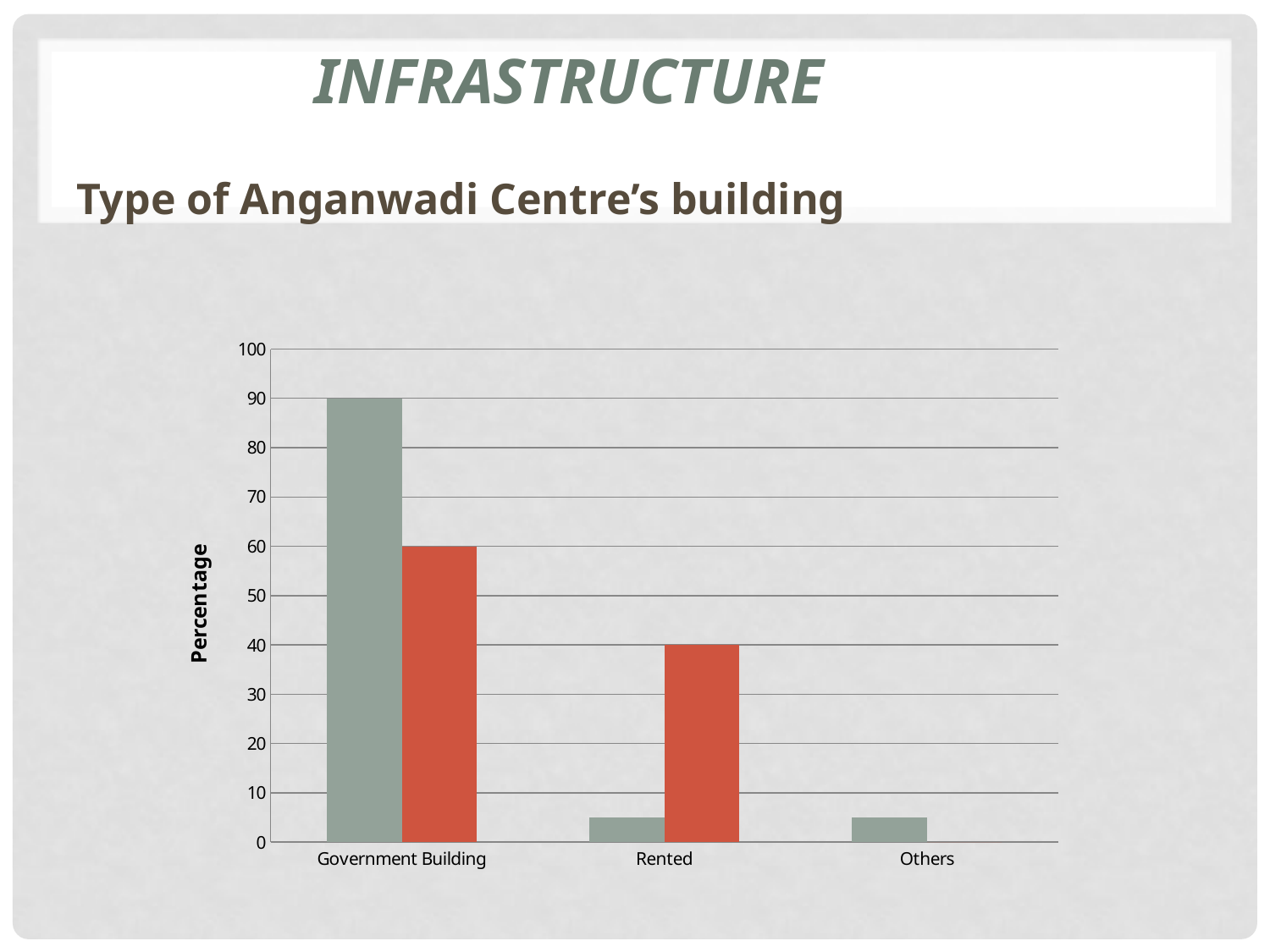
What is the label on the vertical axis of the chart? Percentage Is the value of the grey bar for Rented greater or less than 10? less What is the value of the red bar for Government Building? 60 For Government Building, which bar is larger, the grey bar or the red bar? The grey bar What is the value of the grey bar for Government Building? 90 Which category has the highest grey bar? Government Building What is the value of the red bar for Rented? 40 What kind of chart is shown on the slide? Bar chart How many categories are shown on the x axis of the chart? 3 Is the value of the grey bar for Others greater or less than 10? less What is the difference between the grey bar and the red bar for Government Building? 30 What is the difference between the red bar for Government Building and the red bar for Rented? 20